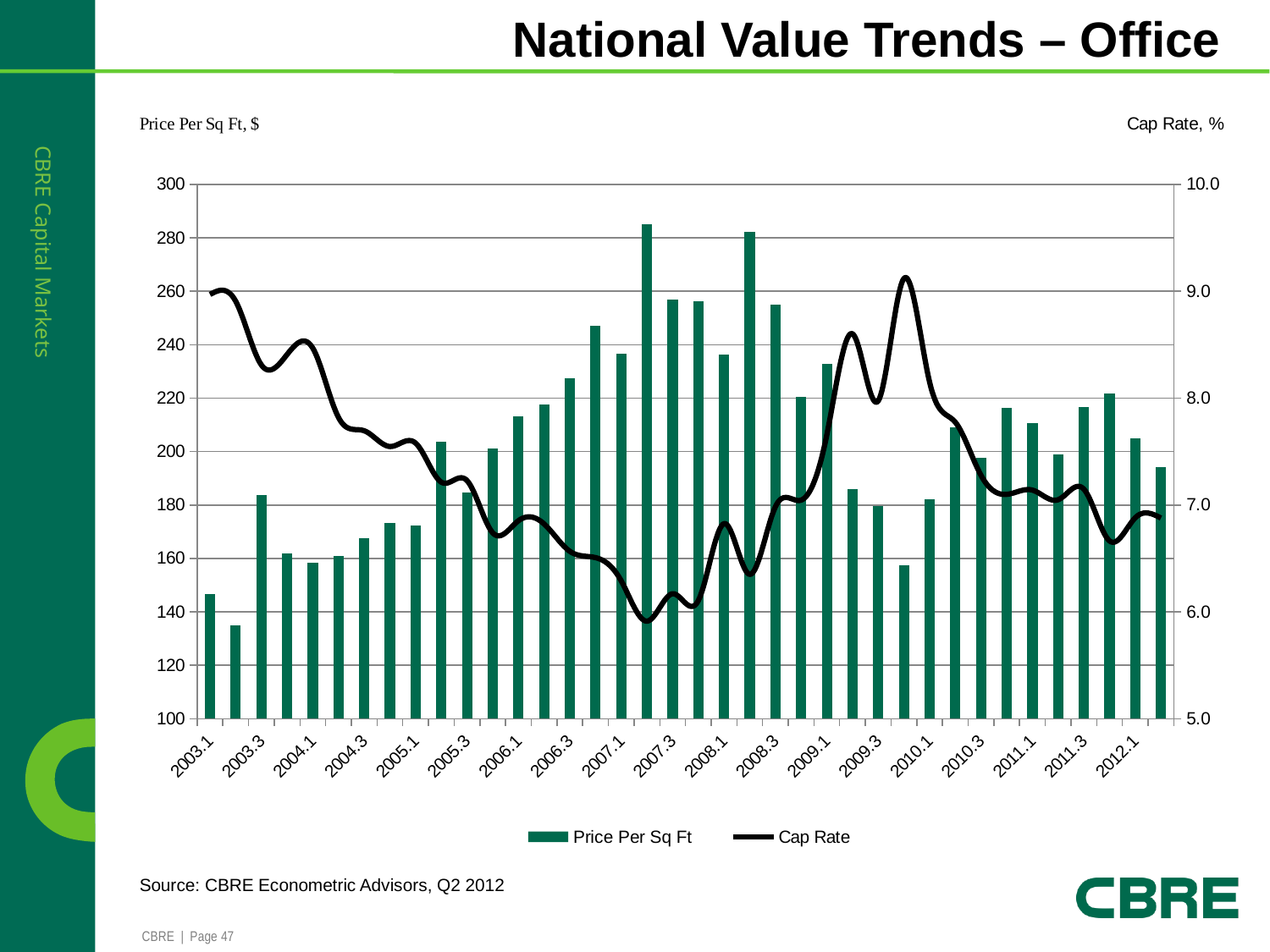
Is the Price Per Sq Ft value for 2007.3 greater or less than 260? less Is the Price Per Sq Ft value for 2008.3 greater or less than 240? greater What is the title of the chart on the slide? National Value Trends – Office How many series does the legend list? 2 Which has the higher Price Per Sq Ft, 2003.1 or 2007.3? 2007.3 Is the Price Per Sq Ft value for 2003.1 greater or less than 160? less Does the Cap Rate line generally rise or fall from 2003.1 to 2007.3? fall What are the two series named in the legend? Price Per Sq Ft and Cap Rate What kind of chart is shown on the slide? A combination bar and line chart Which has the higher Cap Rate, 2007.3 or 2010.1? 2010.1